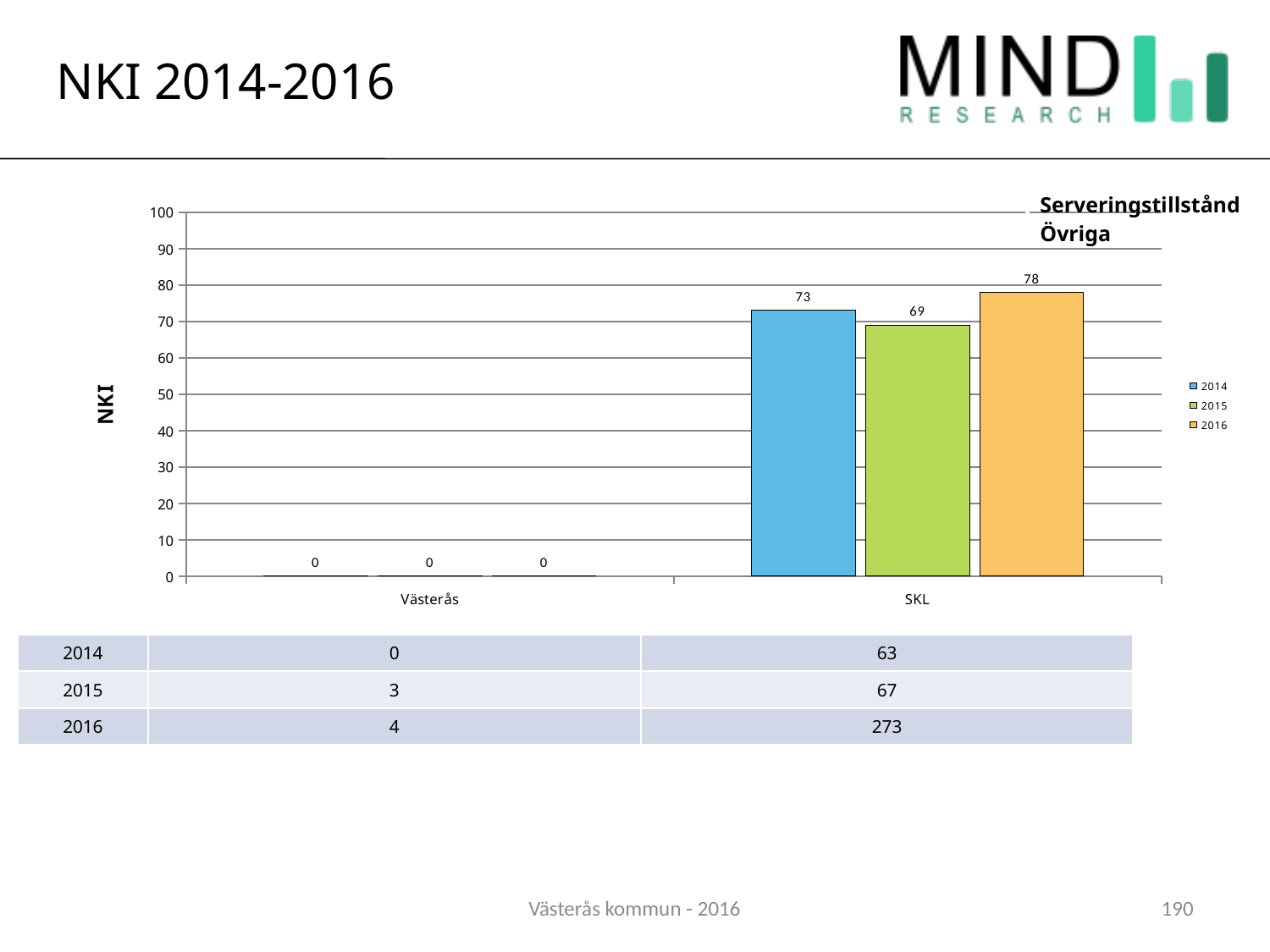
Which year has the highest NKI value for SKL? 2016 Is the SKL value for 2016 greater or less than 70? greater How many categories are shown on the x axis of the chart? 2 Which is larger for SKL: the 2014 value or the 2015 value? 2014 What is the NKI value for SKL in 2016? 78 What is the NKI value for SKL in 2014? 73 What is the difference between the SKL NKI values for 2016 and 2015? 9 What is the NKI value for SKL in 2015? 69 How many series does the chart legend list? 3 Which year has the lowest NKI value for SKL? 2015 What is the NKI value for Västerås in 2015? 0 What type of chart is shown on the slide? Bar chart